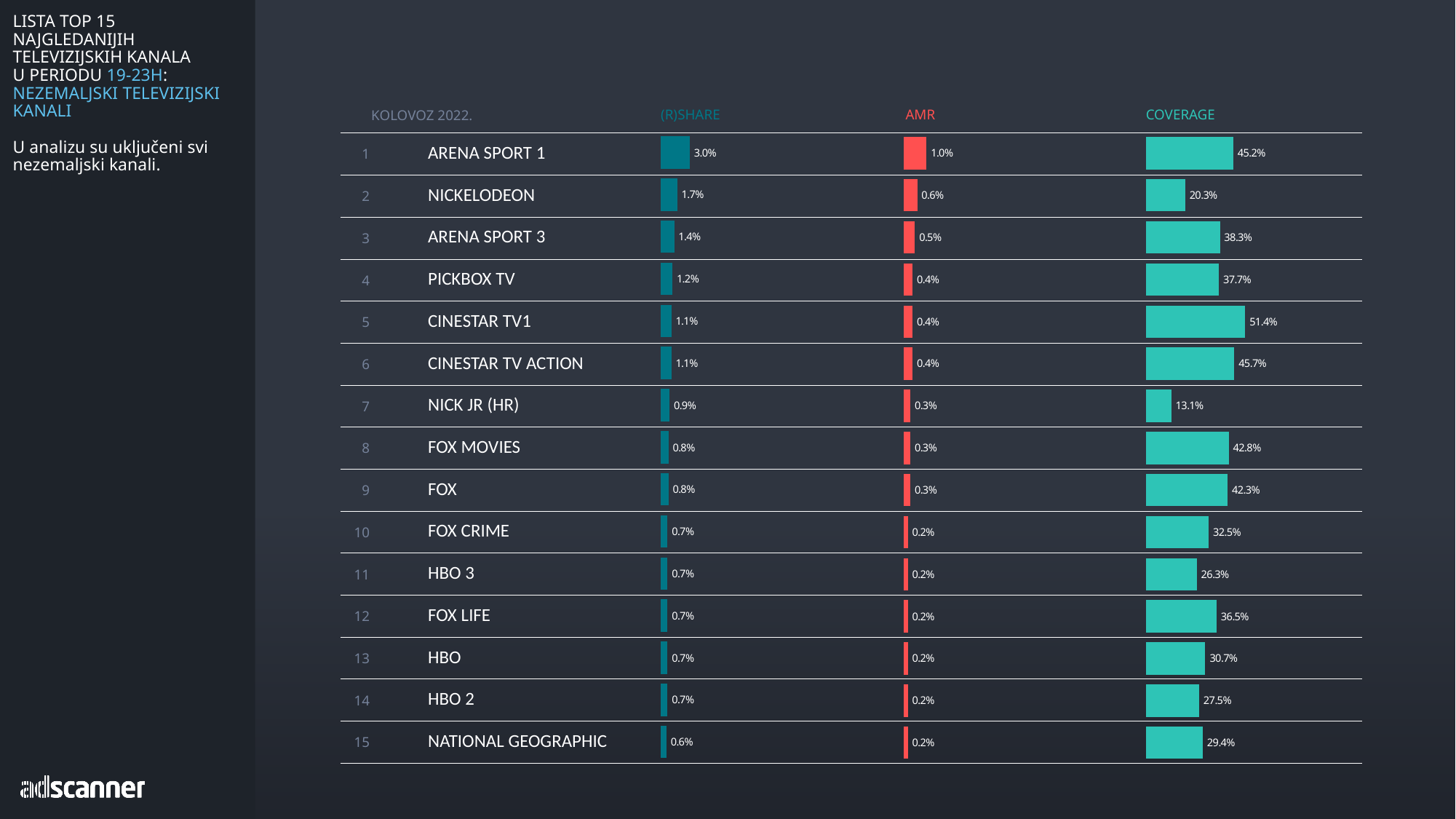
In the COVERAGE chart, what is the difference between CINESTAR TV1 and ARENA SPORT 1? 6.2 percentage points What colour are the bars in the AMR chart? Red In the (R)SHARE chart, what is the difference between ARENA SPORT 1 and NICKELODEON? 1.3 percentage points In the (R)SHARE chart, what is the value for ARENA SPORT 1? 3.0% In the (R)SHARE chart, which channel has the highest value? ARENA SPORT 1 How many channels are listed in the charts? 15 In the COVERAGE chart, which channel has the lowest value? NICK JR (HR) In the COVERAGE chart, what is the value for NICK JR (HR)? 13.1% In the COVERAGE chart, which channel has the highest value? CINESTAR TV1 In the COVERAGE chart, which is larger, FOX MOVIES or HBO 3? FOX MOVIES What kind of chart is used to show the COVERAGE values? Bar chart In the AMR chart, what is the value for NICKELODEON? 0.6%